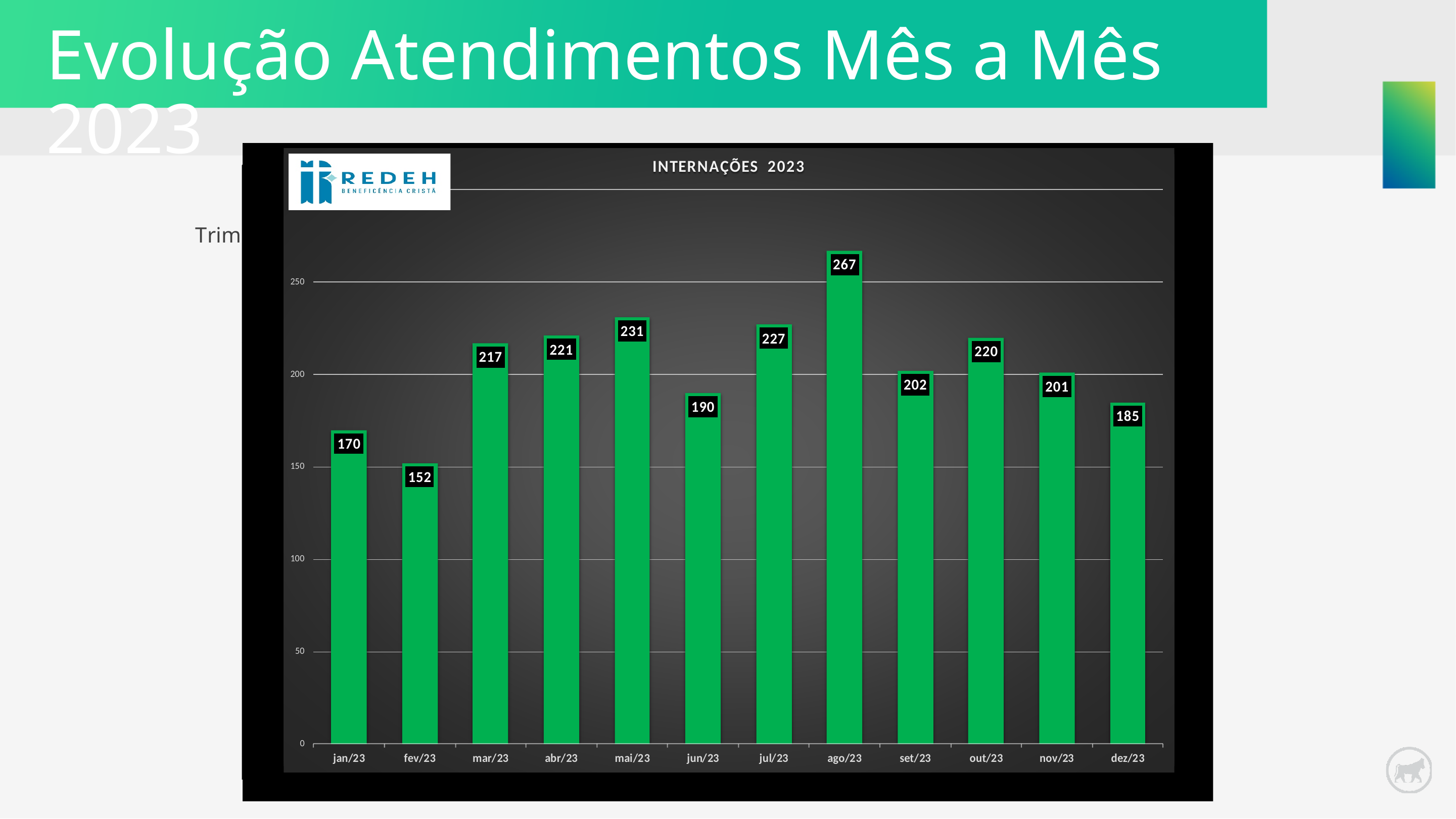
Which month has the lowest value? fev/23 Which month has the highest value? ago/23 What is the value for mai/23? 231 Which is larger, the value for mar/23 or the value for dez/23? mar/23 How many months are shown on the x axis? 12 What is the difference between the values for ago/23 and fev/23? 115 What is the value for ago/23? 267 What is the title of the chart? INTERNAÇÕES 2023 Is the value for jan/23 greater or less than 200? less What kind of chart is shown? bar chart What is the difference between the values for jul/23 and jun/23? 37 What is the value for fev/23? 152